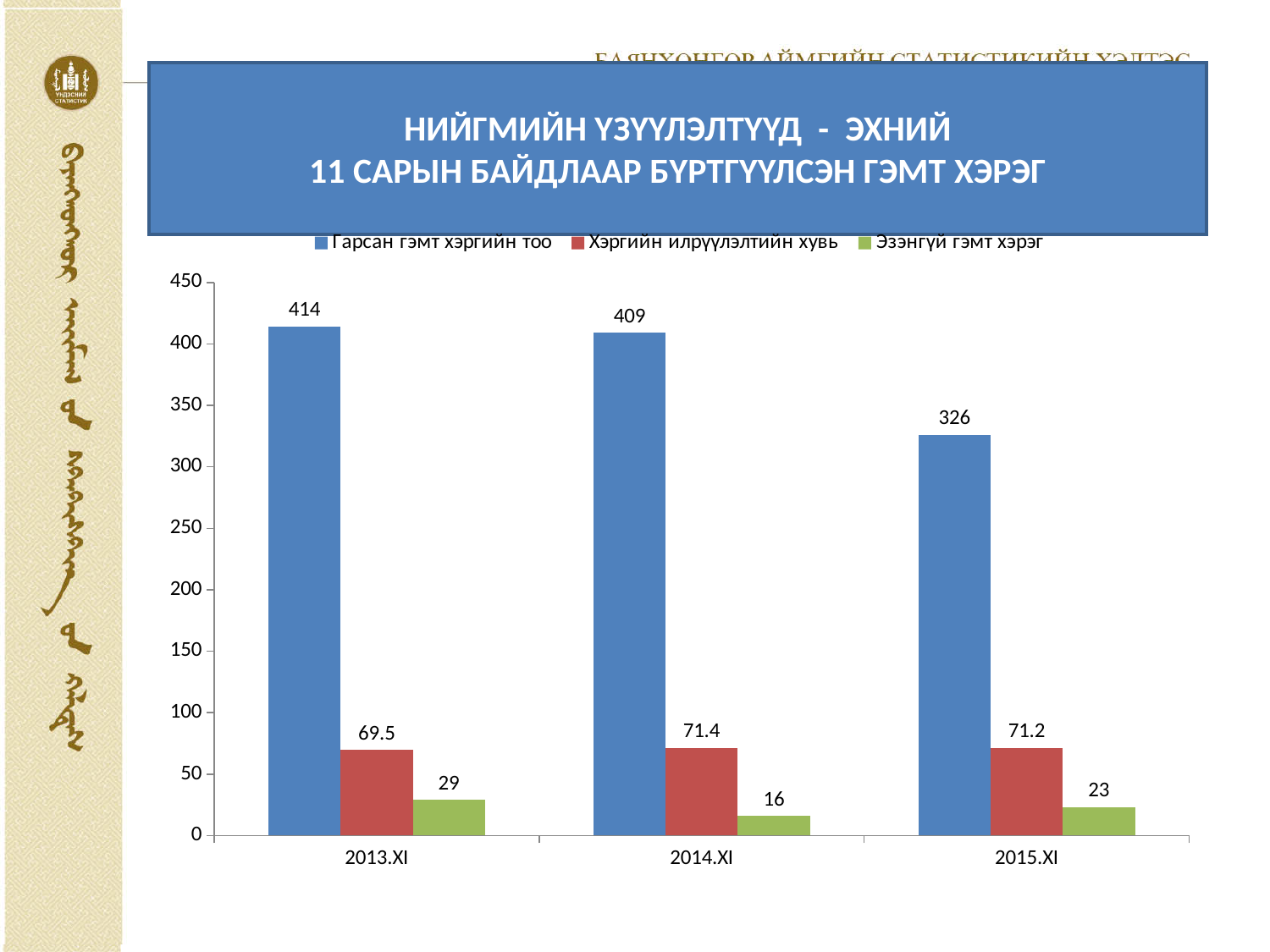
What is the value of Эзэнгүй гэмт хэрэг for 2015.XI? 23 What is the value of Хэргийн илрүүлэлтийн хувь for 2014.XI? 71.4 Is the value of Гарсан гэмт хэргийн тоо for 2015.XI greater or less than 350? less In which period is Эзэнгүй гэмт хэрэг the highest? 2013.XI How many periods are shown on the x axis? 3 In which period is Гарсан гэмт хэргийн тоо the lowest? 2015.XI What is the difference in Гарсан гэмт хэргийн тоо between 2013.XI and 2015.XI? 88 How many series does the legend list? 3 What is the difference in Эзэнгүй гэмт хэрэг between 2013.XI and 2014.XI? 13 Which is larger: Хэргийн илрүүлэлтийн хувь in 2013.XI or in 2014.XI? 2014.XI What is the value of Гарсан гэмт хэргийн тоо for 2013.XI? 414 What kind of chart is shown on the slide? bar chart